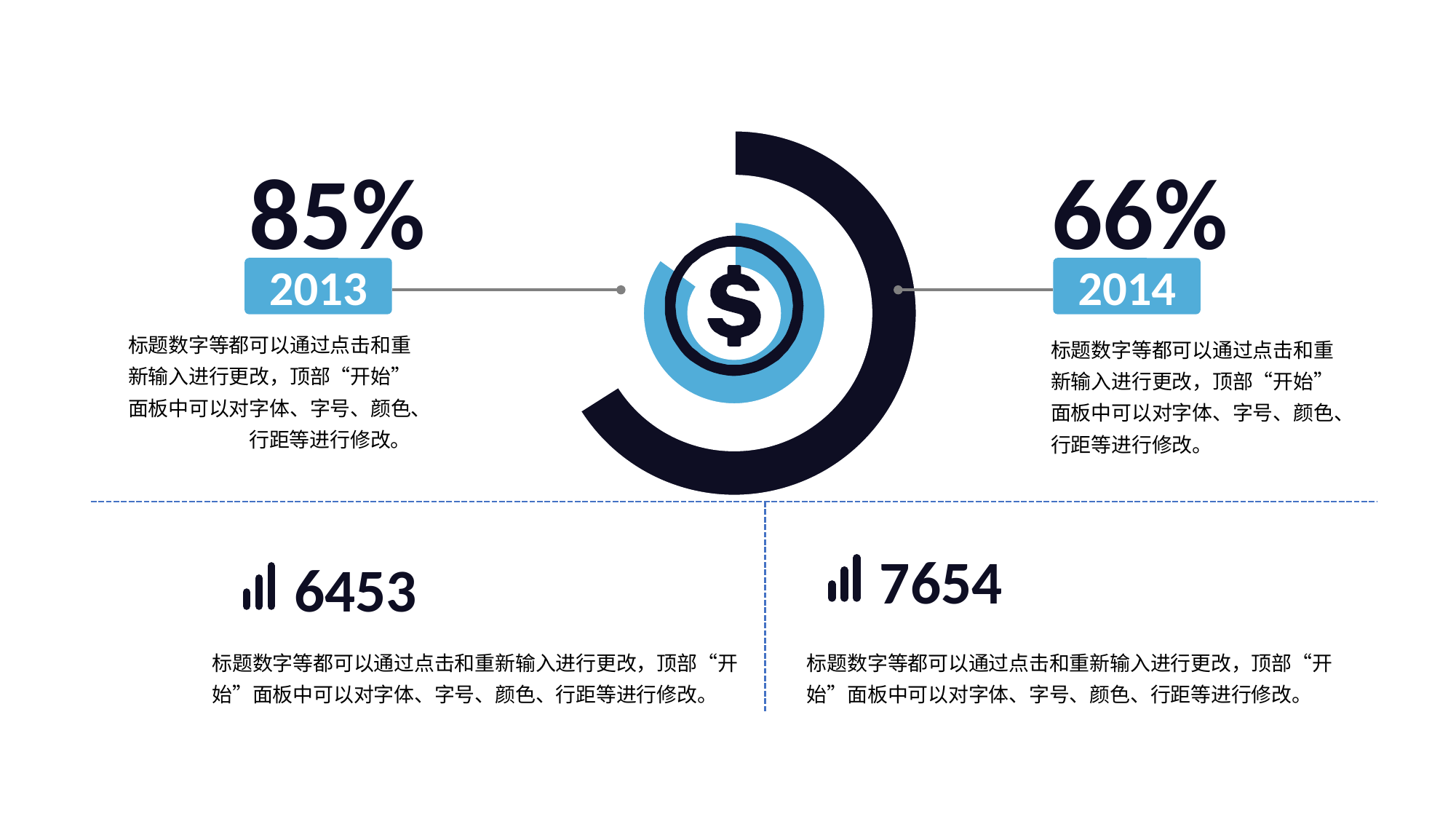
Does the percentage rise or fall from 2013 to 2014? fall Which year has the higher percentage, 2013 or 2014? 2013 What number is shown next to the bar icon in the bottom-left section? 6453 What is the difference in percentage points between 2013 and 2014? 19 What symbol appears in the centre of the ring chart? A dollar sign ($) Which year shows the lowest percentage? 2014 Which of the two bottom figures is larger, 6453 or 7654? 7654 What number is shown next to the bar icon in the bottom-right section? 7654 What percentage is shown for 2013? 85% How many years are labelled on the ring chart? 2 What percentage is shown for 2014? 66% Which year shows the highest percentage? 2013